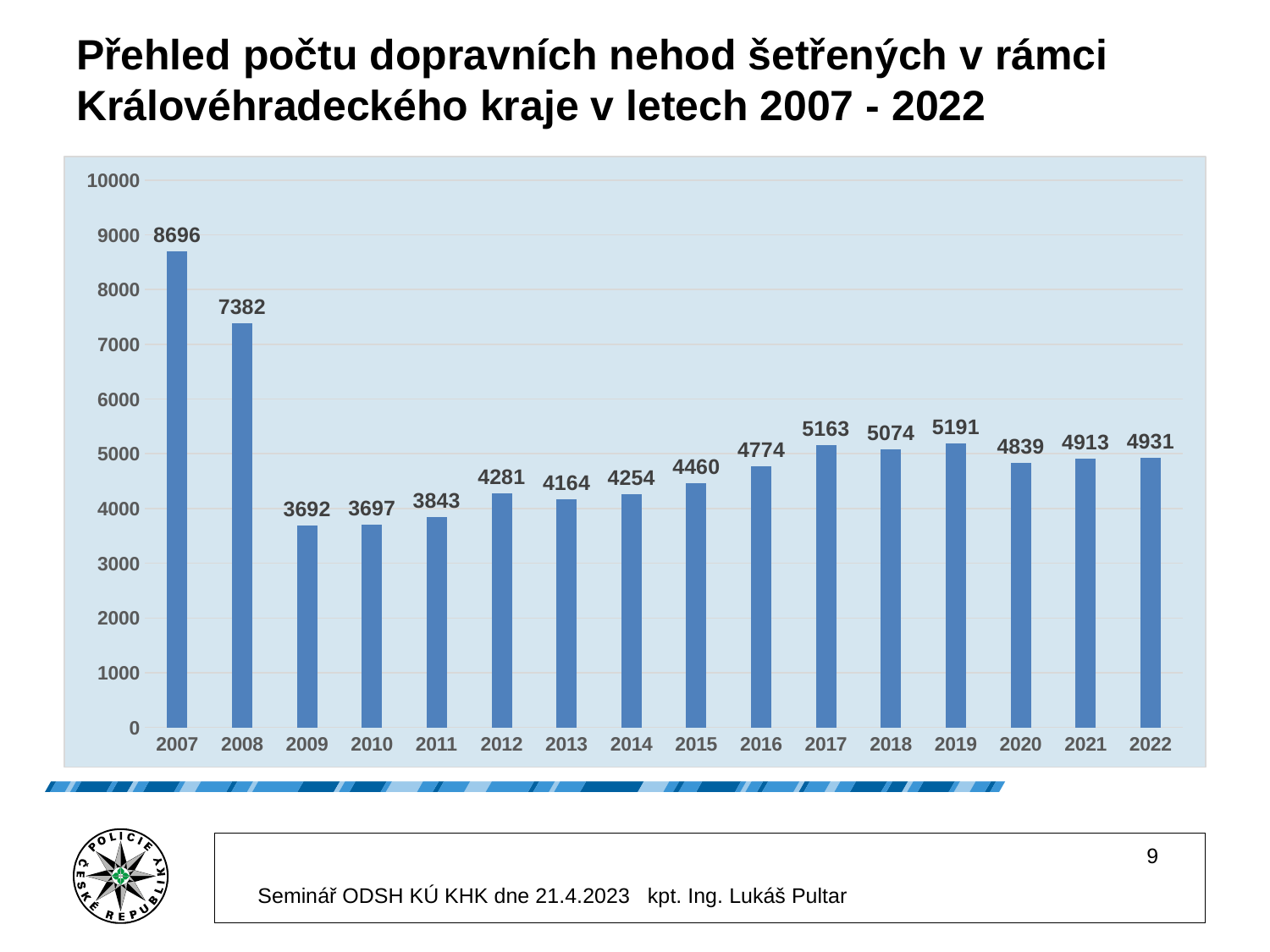
What is the value for 2007? 8696 Is the value for 2016 greater or less than 5000? less What kind of chart is shown on the slide? bar chart Which year has the highest value? 2007 Which year has the lowest value? 2009 What is the value for 2014? 4254 What is the difference between the values for 2022 and 2021? 18 What is the difference between the values for 2007 and 2008? 1314 Which is larger, the value for 2017 or the value for 2018? 2017 How many years are shown on the x axis? 16 What is the value for 2019? 5191 Do the values rise or fall from 2007 to 2009? fall